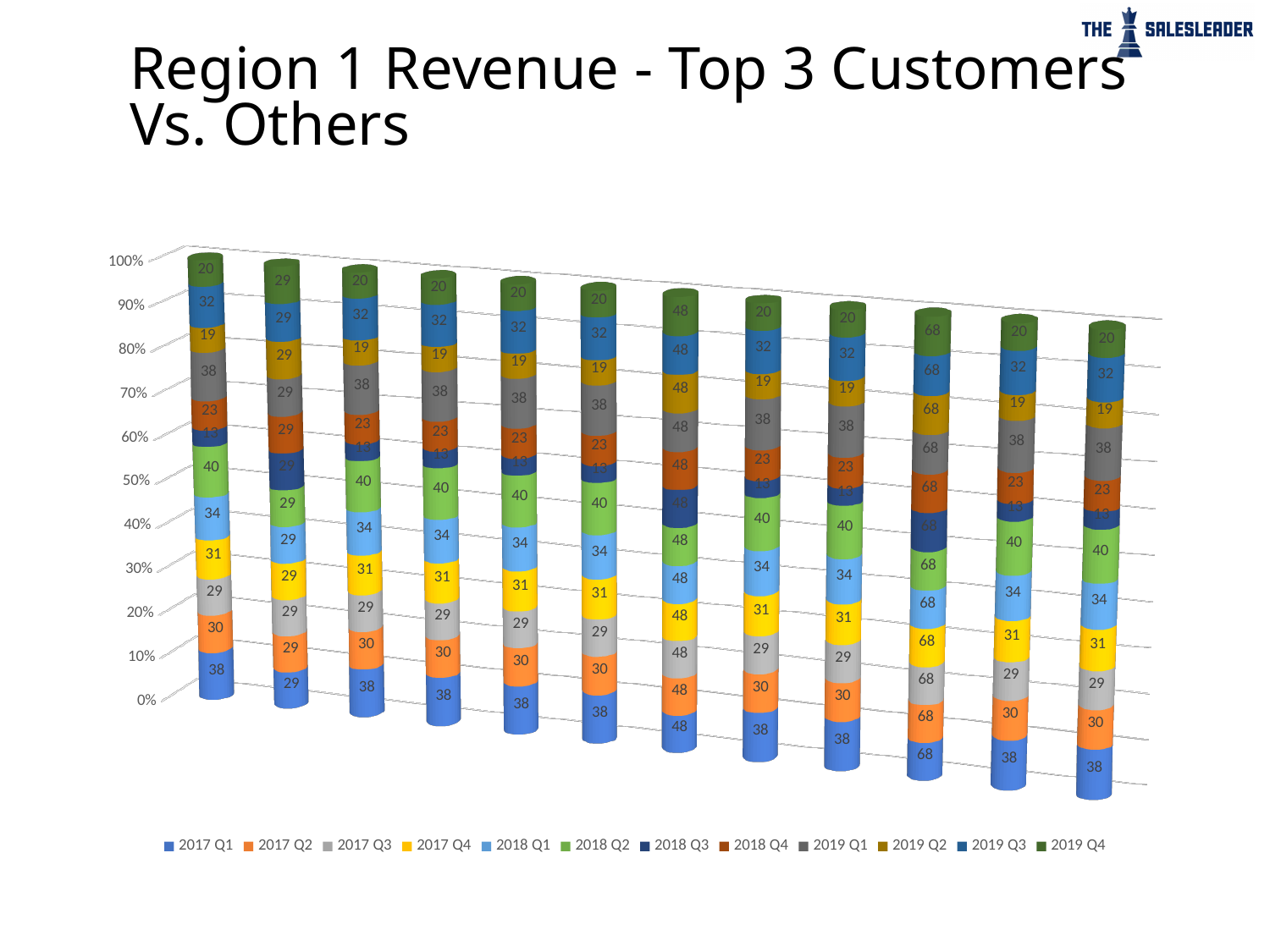
In the first (leftmost) bar, what is the value labelled for the 2017 Q1 segment? 38 What is the title of the chart slide? Region 1 Revenue - Top 3 Customers Vs. Others In the first (leftmost) bar, what is the value labelled for the 2018 Q3 segment? 13 In the first (leftmost) bar, which series has the smallest labelled segment? 2018 Q3 How many stacked bars are plotted in the chart? 12 In the tenth bar from the left, what is the value labelled for the 2019 Q4 segment? 68 In the seventh bar from the left, what is the value labelled for the 2017 Q3 segment? 48 In the second bar from the left, what is the value labelled for the 2018 Q2 segment? 29 In the first (leftmost) bar, what is the difference between the 2017 Q1 segment and the 2018 Q3 segment? 25 What is the first entry in the chart legend? 2017 Q1 How many series does the legend list? 12 What kind of chart is shown on the slide? Stacked bar chart